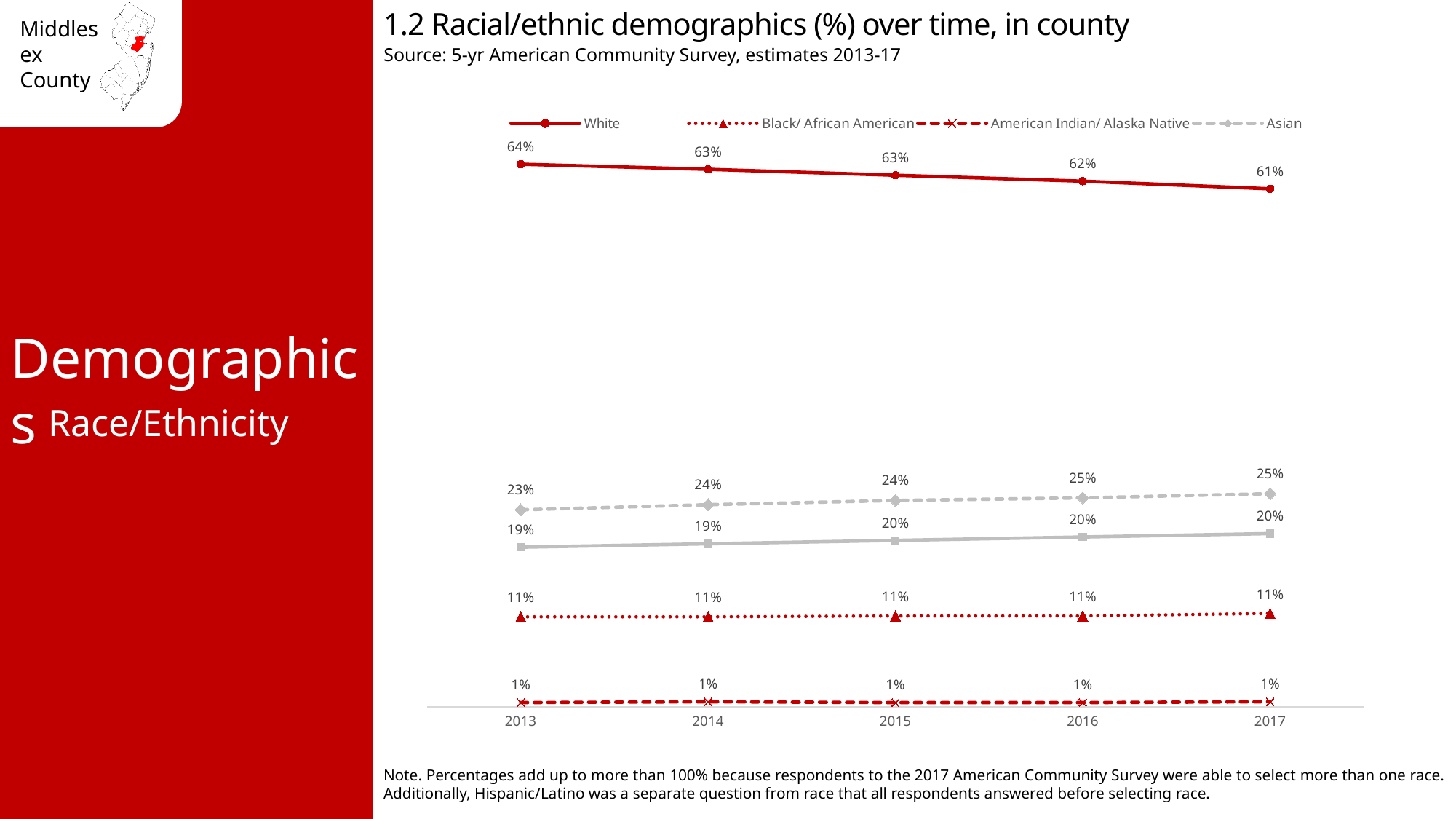
What was the percentage for American Indian/ Alaska Native in 2016? 1% How many series does the legend list? 4 Does the White series rise or fall from 2013 to 2017? fall What kind of chart is shown on the slide? line chart Which series has the lowest values across all years? American Indian/ Alaska Native What was the percentage for White in 2013? 64% What was the percentage for Asian in 2013? 23% What was the percentage for White in 2017? 61% Does the Asian series rise or fall from 2013 to 2017? rise How many years are shown on the x axis? 5 By how many percentage points did the White share change between 2013 and 2017? 3 percentage points What was the percentage for Black/ African American in 2015? 11%